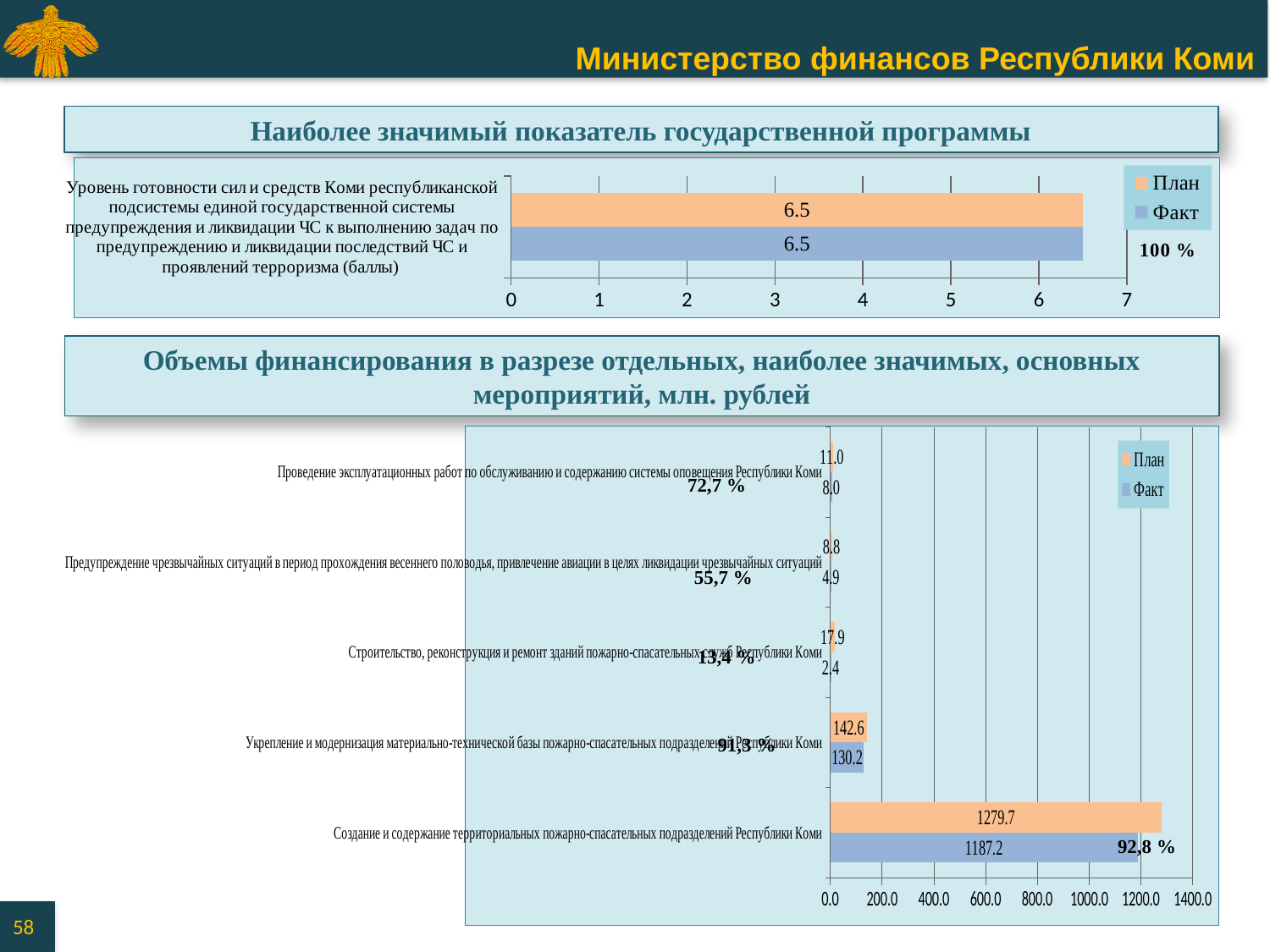
In the bottom chart (Объемы финансирования), what is the Факт value for Строительство, реконструкция и ремонт зданий пожарно-спасательных служб Республики Коми? 2.4 In the bottom chart (Объемы финансирования), what is the Факт value for Укрепление и модернизация материально-технической базы пожарно-спасательных подразделений Республики Коми? 130.2 In the top chart (Наиболее значимый показатель государственной программы), what is the Факт value? 6.5 In the top chart (Наиболее значимый показатель государственной программы), how many series does the legend list? 2 In the bottom chart (Объемы финансирования), which category has the highest План value? Создание и содержание территориальных пожарно-спасательных подразделений Республики Коми In the top chart (Наиболее значимый показатель государственной программы), what is the План value? 6.5 What kind of chart is the top chart (Наиболее значимый показатель государственной программы)? Bar chart In the bottom chart (Объемы финансирования), what is the План value for Создание и содержание территориальных пожарно-спасательных подразделений Республики Коми? 1279.7 In the bottom chart (Объемы финансирования), what is the difference between the План and Факт values for Создание и содержание территориальных пожарно-спасательных подразделений Республики Коми? 92.5 In the bottom chart (Объемы финансирования), which is larger for Проведение эксплуатационных работ по обслуживанию и содержанию системы оповещения Республики Коми: План or Факт? План How many categories are shown in the bottom chart (Объемы финансирования)? 5 In the bottom chart (Объемы финансирования), which category has the lowest Факт value? Строительство, реконструкция и ремонт зданий пожарно-спасательных служб Республики Коми